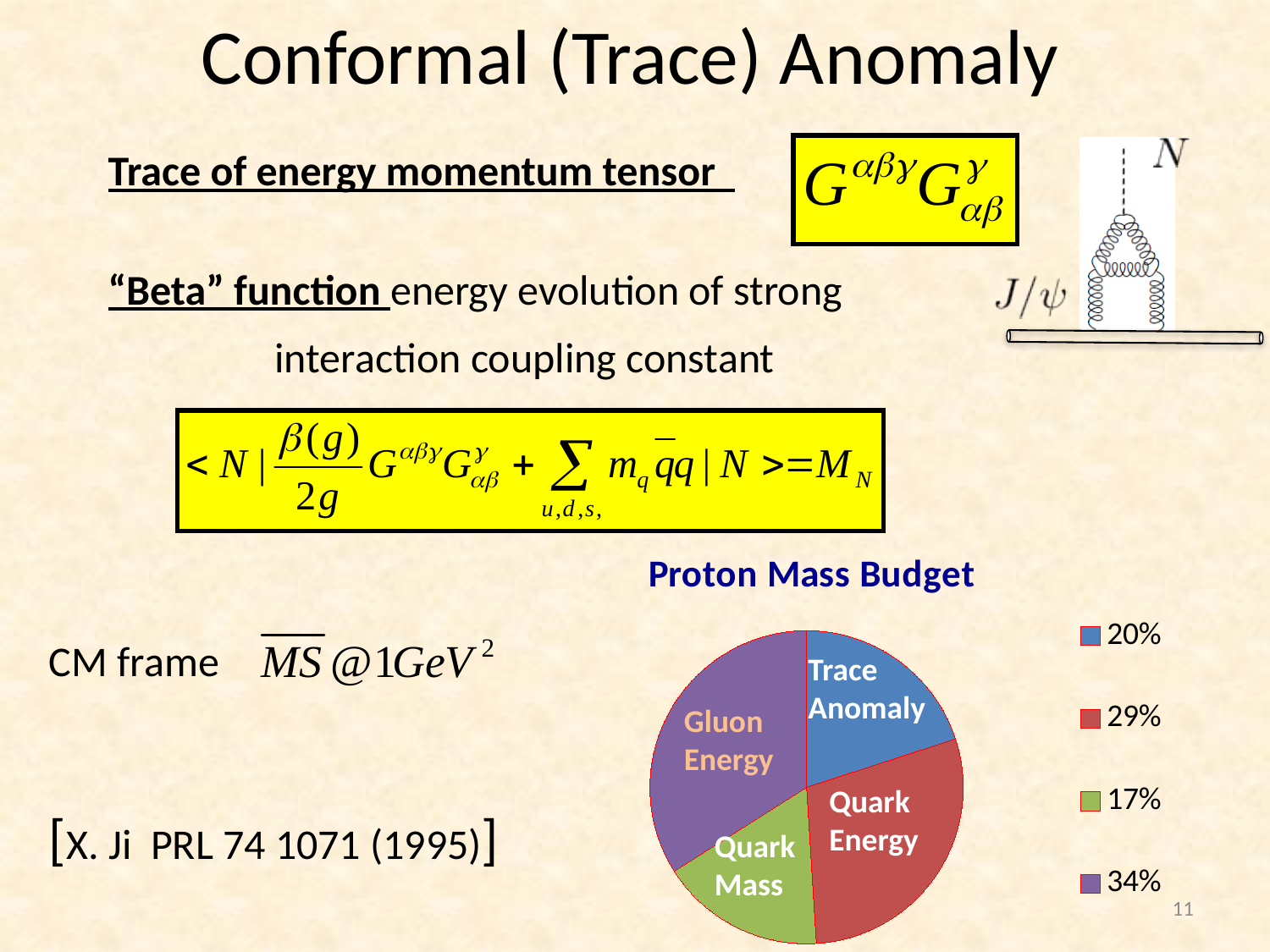
Which slice of the Proton Mass Budget pie chart is the largest? Gluon Energy In the Proton Mass Budget pie chart, what share is the Trace Anomaly slice? 20% Which slice of the Proton Mass Budget pie chart is the smallest? Quark Mass How many entries does the legend of the Proton Mass Budget pie chart list? 4 How many slices does the Proton Mass Budget pie chart have? 4 In the Proton Mass Budget pie chart, what is the difference between the Gluon Energy share and the Quark Mass share? 17% What is the title of the pie chart? Proton Mass Budget In the Proton Mass Budget pie chart, which is larger: Quark Energy or Trace Anomaly? Quark Energy What kind of chart is shown under the heading "Proton Mass Budget"? pie chart In the Proton Mass Budget pie chart, what share is the Quark Mass slice? 17% In the Proton Mass Budget pie chart, what share is the Gluon Energy slice? 34%